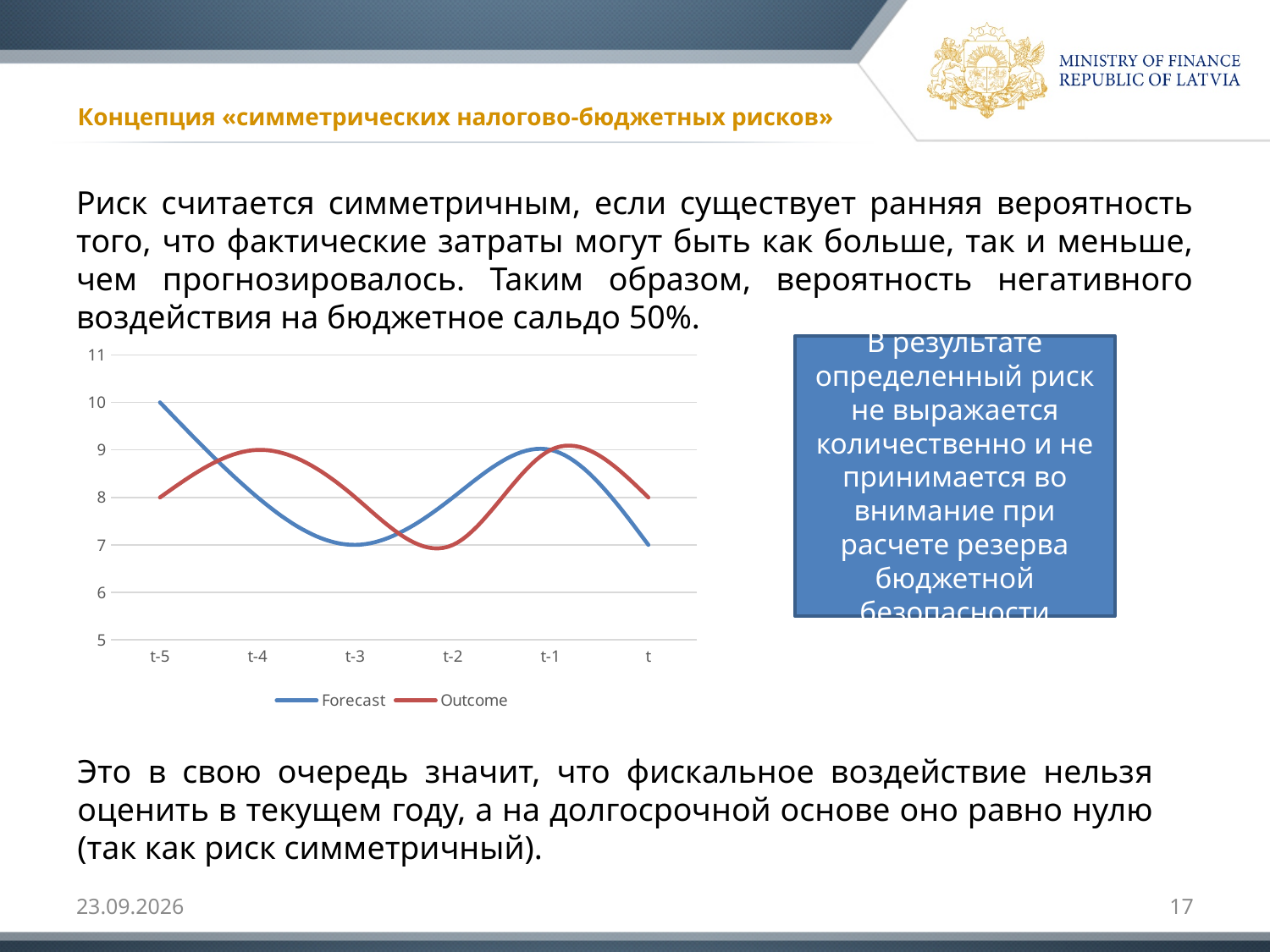
What is the Outcome value at t? 8 Which is larger at t-5, Forecast or Outcome? Forecast How many points are plotted along the x axis of the chart? 6 How many series does the chart legend list? 2 Does the Forecast series rise or fall from t-5 to t-3? fall What is the difference between the Forecast and Outcome values at t-5? 2 What is the Forecast value at t? 7 At which x-axis point is the Forecast series highest? t-5 What kind of chart is shown on the slide? line chart What is the Outcome value at t-5? 8 Is the Forecast value at t-3 greater or less than 8? less What is the Forecast value at t-5? 10